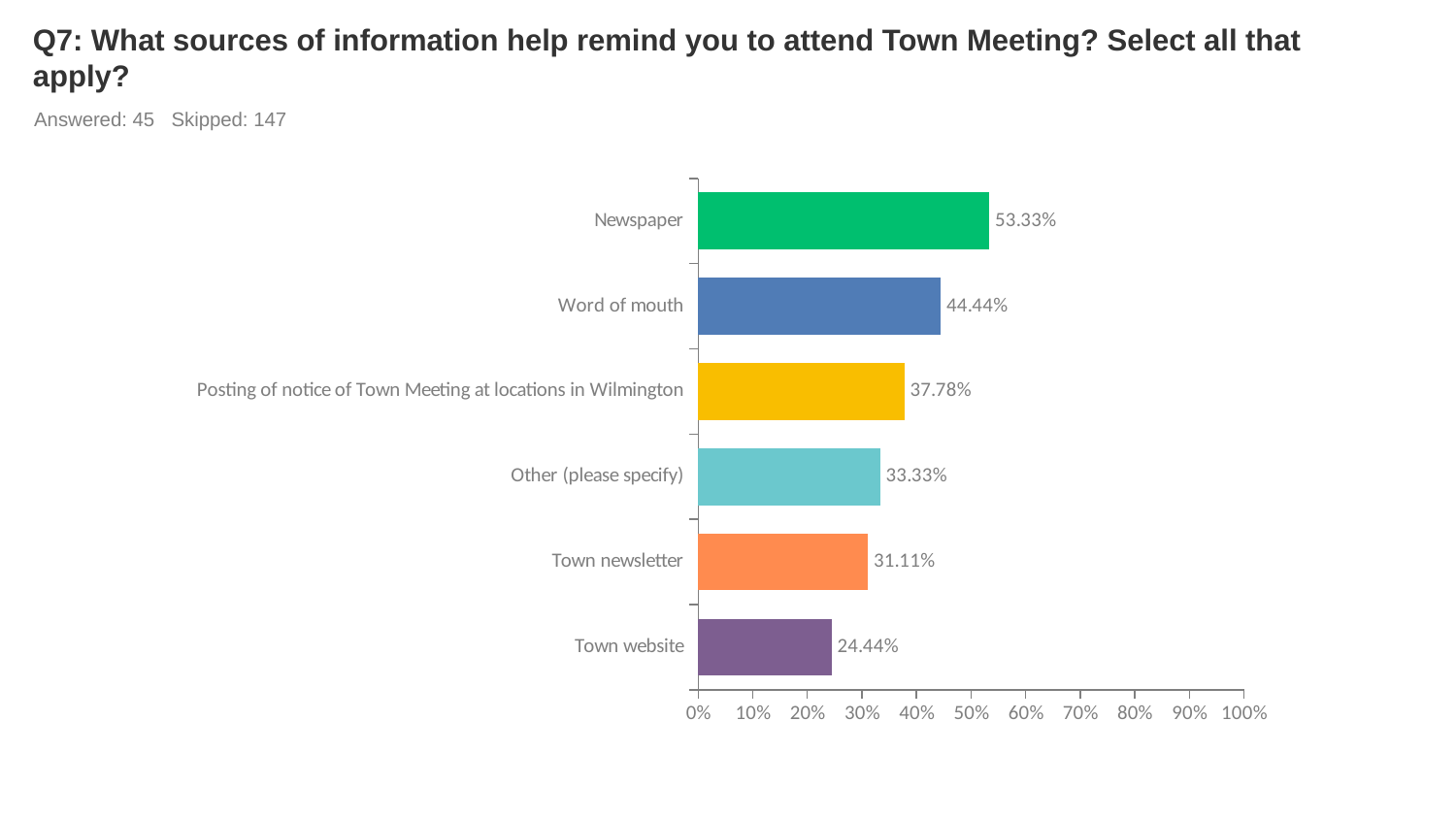
Which source has the highest percentage? Newspaper What percentage of respondents selected Newspaper? 53.33% How many categories are shown in the chart? 6 What percentage is shown for Posting of notice of Town Meeting at locations in Wilmington? 37.78% Which source has the lowest percentage? Town website Which is larger, Town newsletter or Other (please specify)? Other (please specify) What is the difference between the values for Town newsletter and Town website? 6.67% Is the value for Word of mouth greater or less than 40%? greater How many respondents answered this question according to the slide? 45 What is the value for Town website? 24.44% What is the difference between the values for Newspaper and Word of mouth? 8.89% What kind of chart is shown on the slide? Bar chart